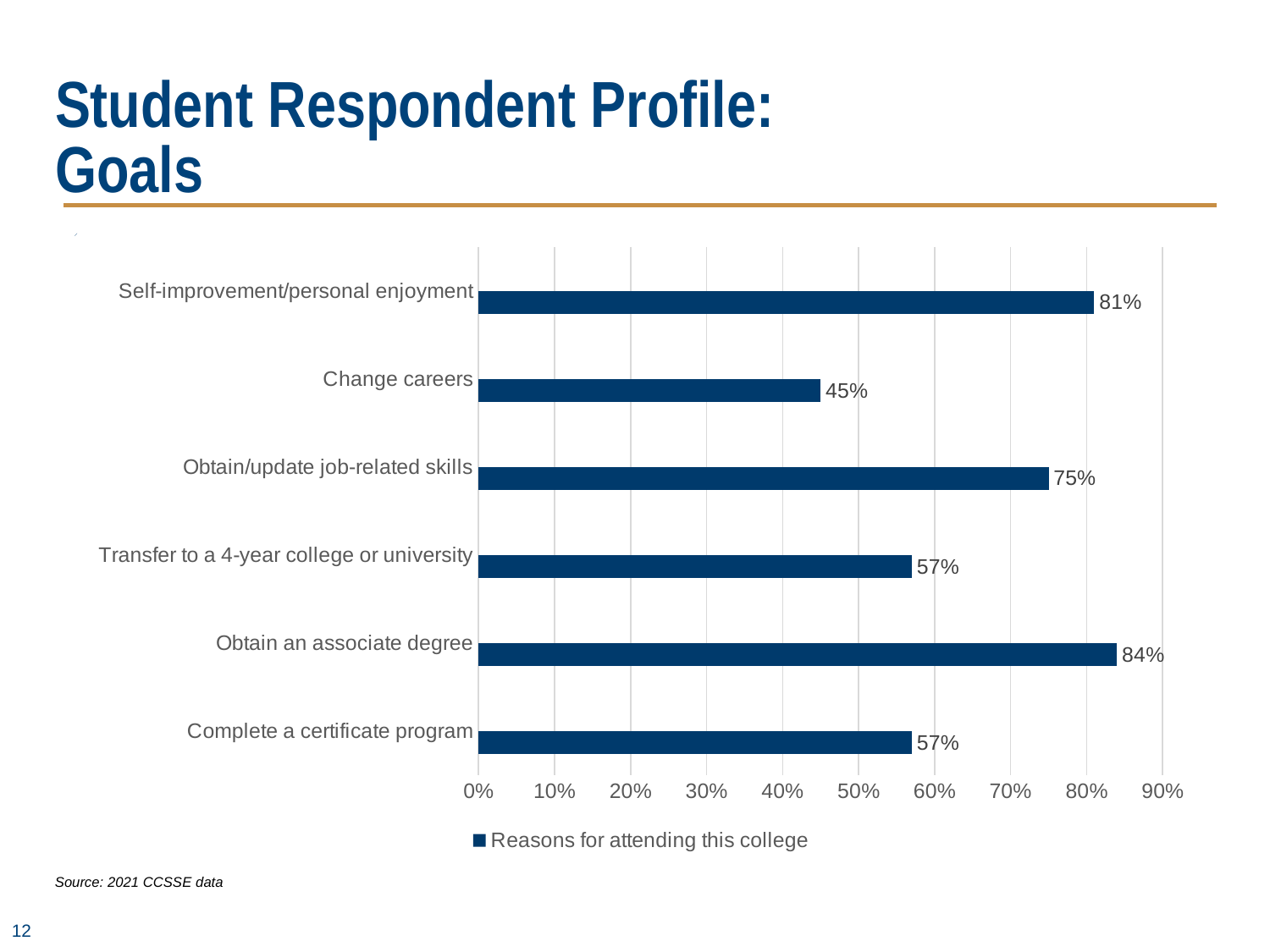
What is the difference between 'Obtain an associate degree' and 'Self-improvement/personal enjoyment'? 3% What is the value for 'Obtain/update job-related skills'? 75% Which reason for attending has the lowest percentage? Change careers What is the difference between 'Obtain/update job-related skills' and 'Change careers'? 30% Which reason for attending has the highest percentage? Obtain an associate degree Which is larger: 'Self-improvement/personal enjoyment' or 'Obtain/update job-related skills'? Self-improvement/personal enjoyment What percentage of respondents cited 'Obtain an associate degree' as a reason for attending this college? 84% What is the value for 'Change careers'? 45% What series name does the legend show? Reasons for attending this college Is the value for 'Transfer to a 4-year college or university' greater or less than 50%? greater How many reasons for attending are shown in the chart? 6 What kind of chart is shown on the slide? Bar chart